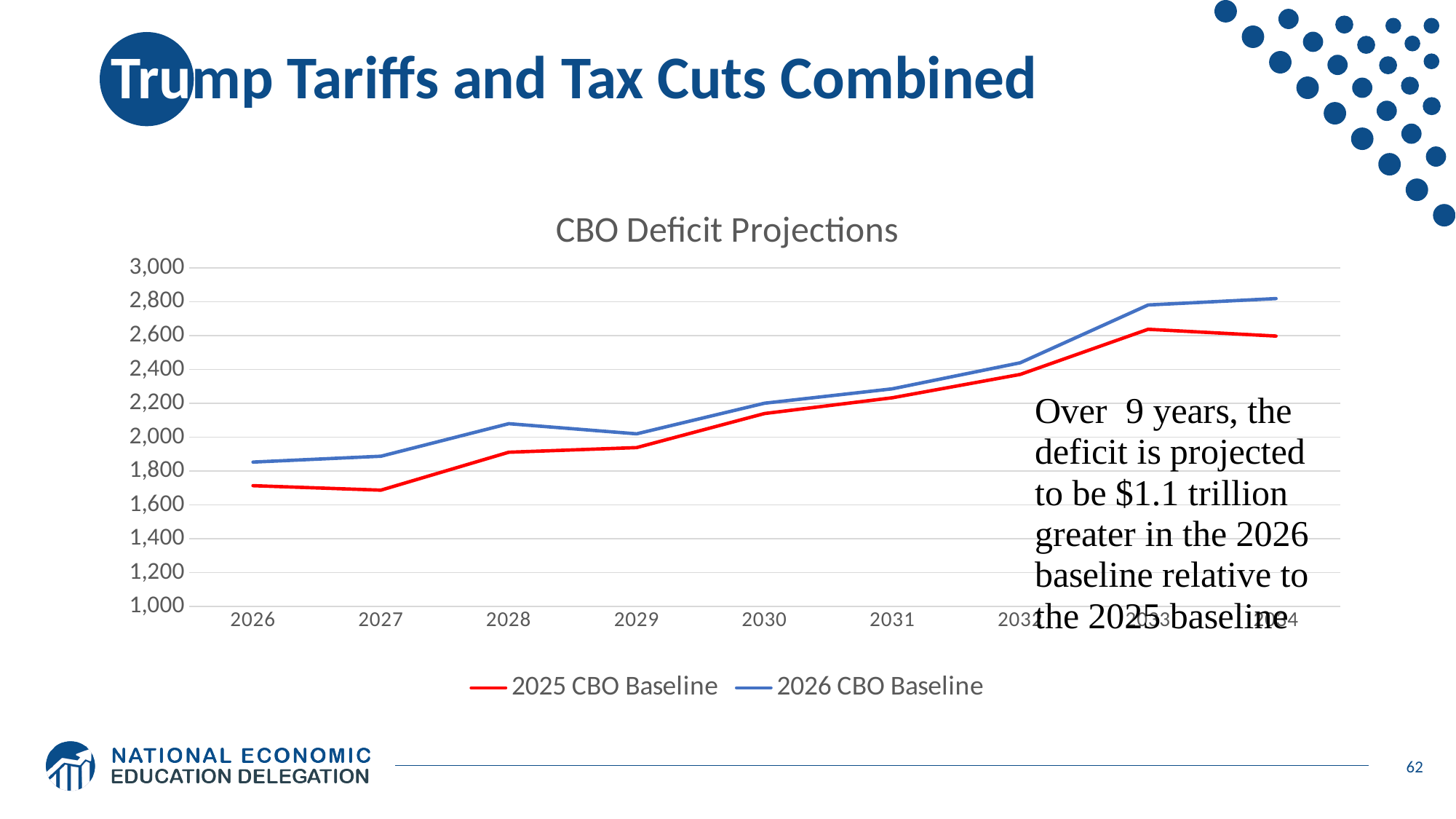
In which year is the 2025 CBO Baseline at its lowest value? 2027 What kind of chart is shown on the slide? line chart How many years are plotted along the x axis of the chart? 9 What is the title of the chart? CBO Deficit Projections In 2026, which series has the higher value: 2025 CBO Baseline or 2026 CBO Baseline? 2026 CBO Baseline Do the deficit projections generally rise or fall from 2026 to 2034? rise In which year does the 2025 CBO Baseline reach its highest value? 2033 Is the value for the 2025 CBO Baseline in 2026 greater or less than 1,800? less How many series does the chart's legend list? 2 Which colour is used for the 2025 CBO Baseline line? red In which year does the 2026 CBO Baseline reach its highest value? 2034 Is the value for the 2026 CBO Baseline in 2028 greater or less than 2,000? greater